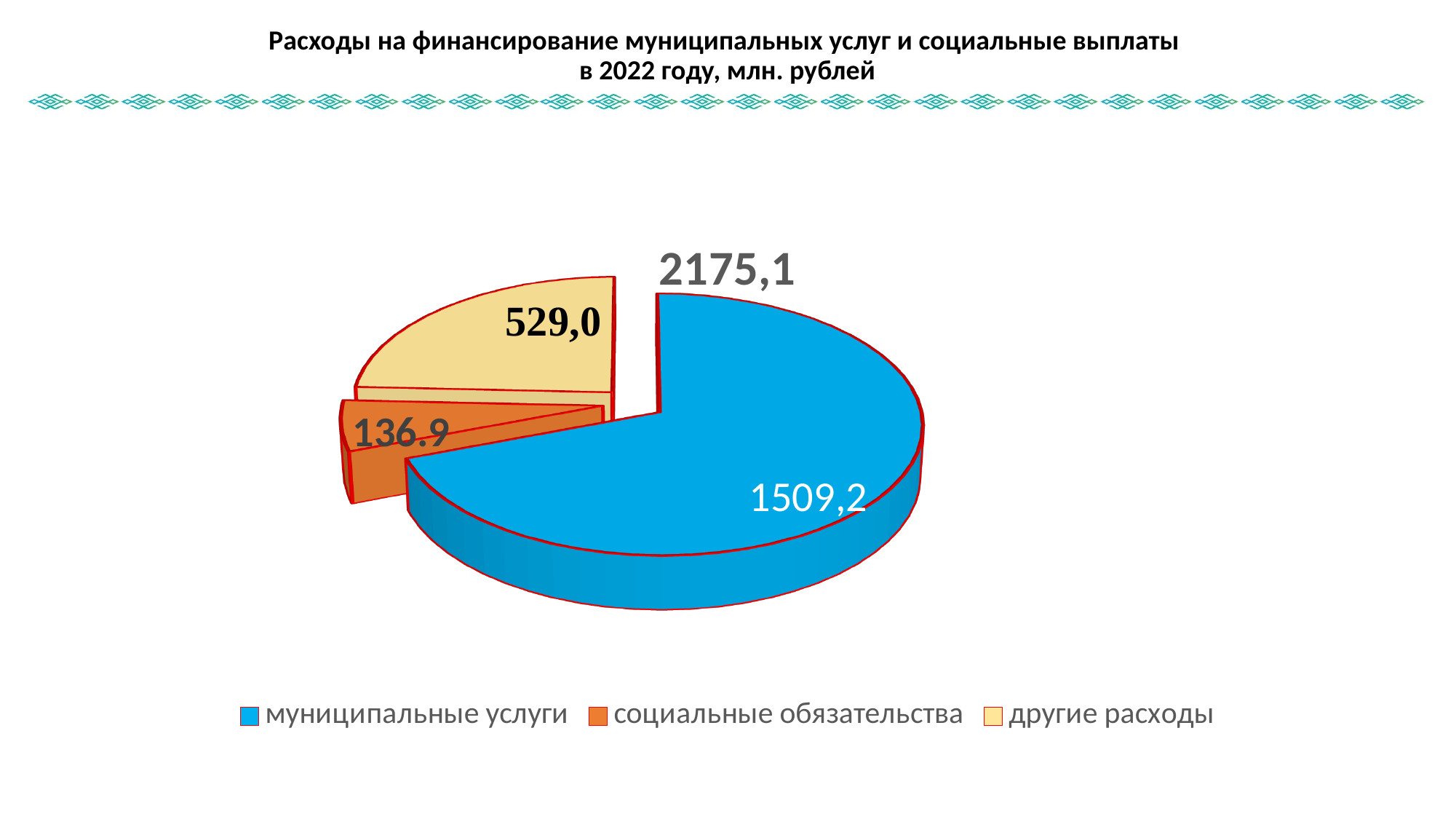
What is the difference between the values for муниципальные услуги and другие расходы? 980,2 What is the difference between the values for другие расходы and социальные обязательства? 392,1 What is the value for другие расходы? 529,0 What colour is the slice for муниципальные услуги? blue Which is larger, другие расходы or социальные обязательства? другие расходы How many slices does the pie chart have? 3 What type of chart is shown on the slide? pie chart What is the value for муниципальные услуги? 1509,2 What is the value for социальные обязательства? 136,9 Which category has the largest slice of the pie? муниципальные услуги Which category has the smallest slice of the pie? социальные обязательства What is the total of all slices shown on the chart? 2175,1